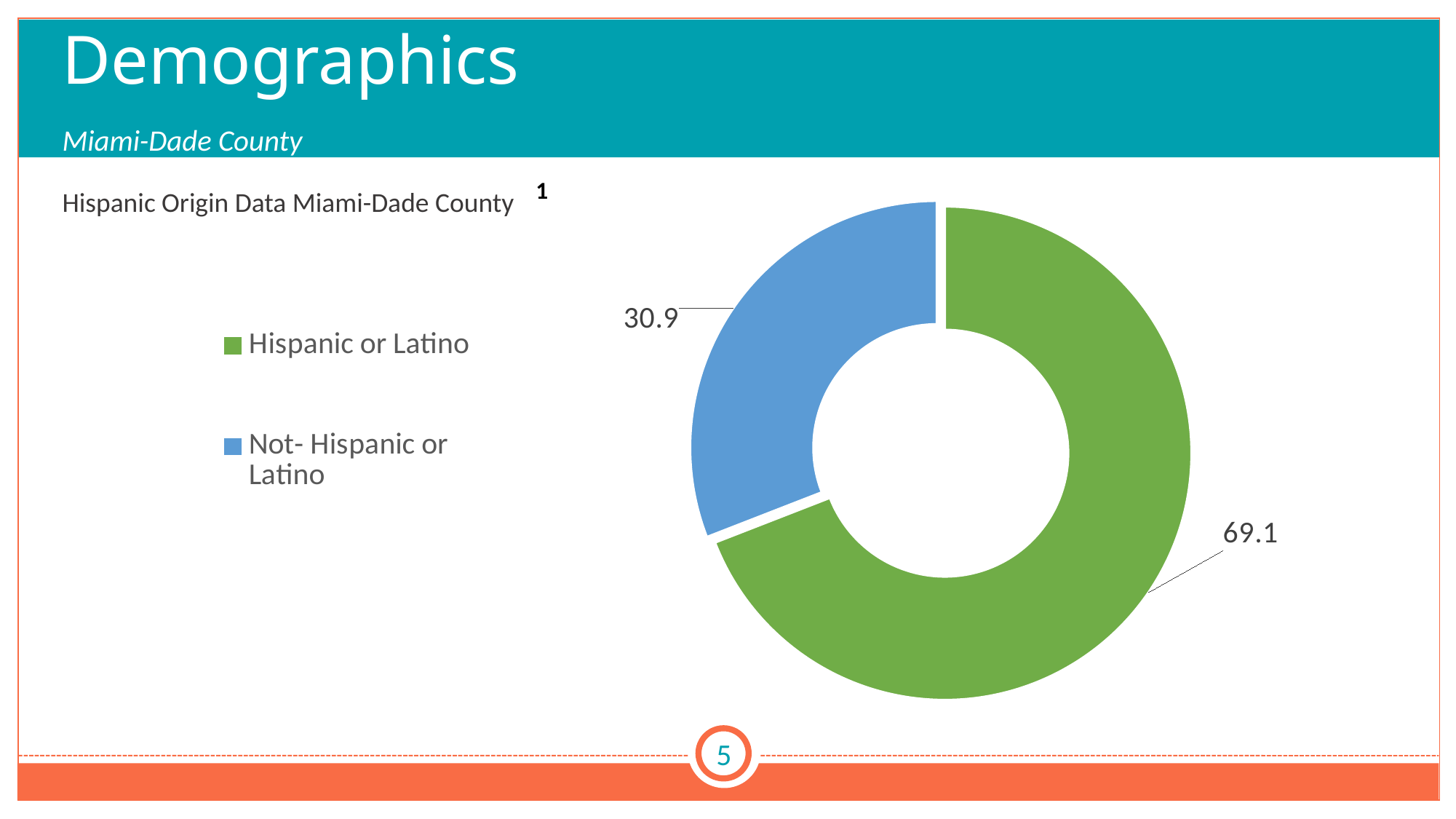
What kind of chart is shown on the slide? Doughnut chart How many entries does the legend list? 2 Which category has the smallest slice? Not- Hispanic or Latino What is the total of the two values shown on the chart? 100 How many categories does the chart show? 2 What is the value for Not- Hispanic or Latino? 30.9 What is the title of the chart? Hispanic Origin Data Miami-Dade County What is the value for Hispanic or Latino? 69.1 What colour is the Hispanic or Latino slice? Green Which category has the largest slice? Hispanic or Latino Which is larger, the Hispanic or Latino slice or the Not- Hispanic or Latino slice? Hispanic or Latino What is the difference between the Hispanic or Latino value and the Not- Hispanic or Latino value? 38.2